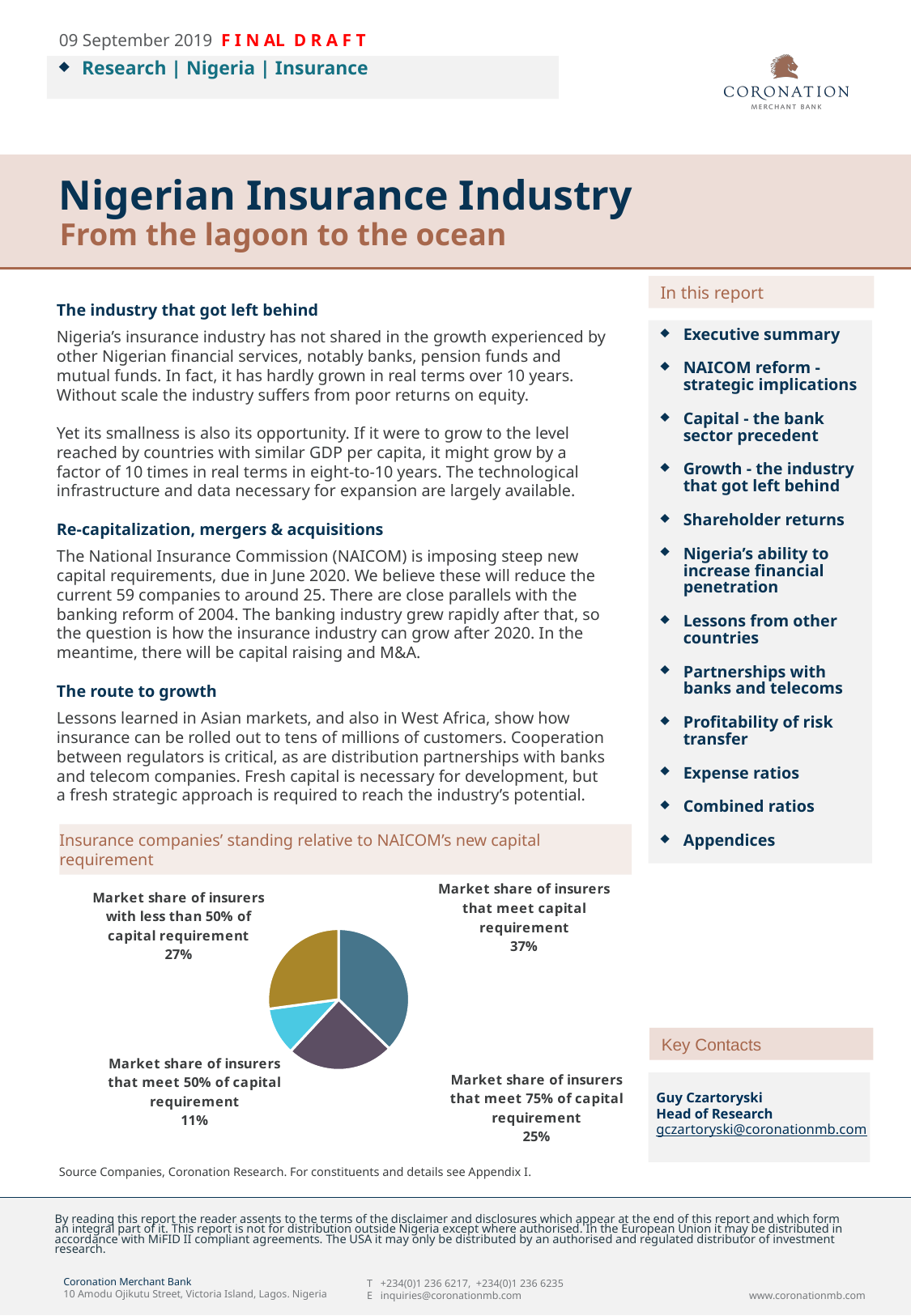
What is the title of the pie chart? Insurance companies' standing relative to NAICOM's new capital requirement What is the market share of insurers with less than 50% of the capital requirement? 27% Which is larger: the market share of insurers with less than 50% of the capital requirement or the market share of insurers that meet 75% of the capital requirement? Insurers with less than 50% of capital requirement How many slices does the pie chart have? 4 What is the market share of insurers that meet 50% of the capital requirement? 11% What is the difference in market share between insurers that meet the capital requirement and insurers that meet 75% of the capital requirement? 12% Which group of insurers has the largest market share in the pie chart? Insurers that meet capital requirement What type of chart is shown on the slide? Pie chart Which group of insurers has the smallest market share in the pie chart? Insurers that meet 50% of capital requirement What is the combined market share of insurers that meet 50% of the capital requirement and insurers with less than 50% of the capital requirement? 38% What is the market share of insurers that meet 75% of the capital requirement? 25% What is the market share of insurers that meet the capital requirement? 37%